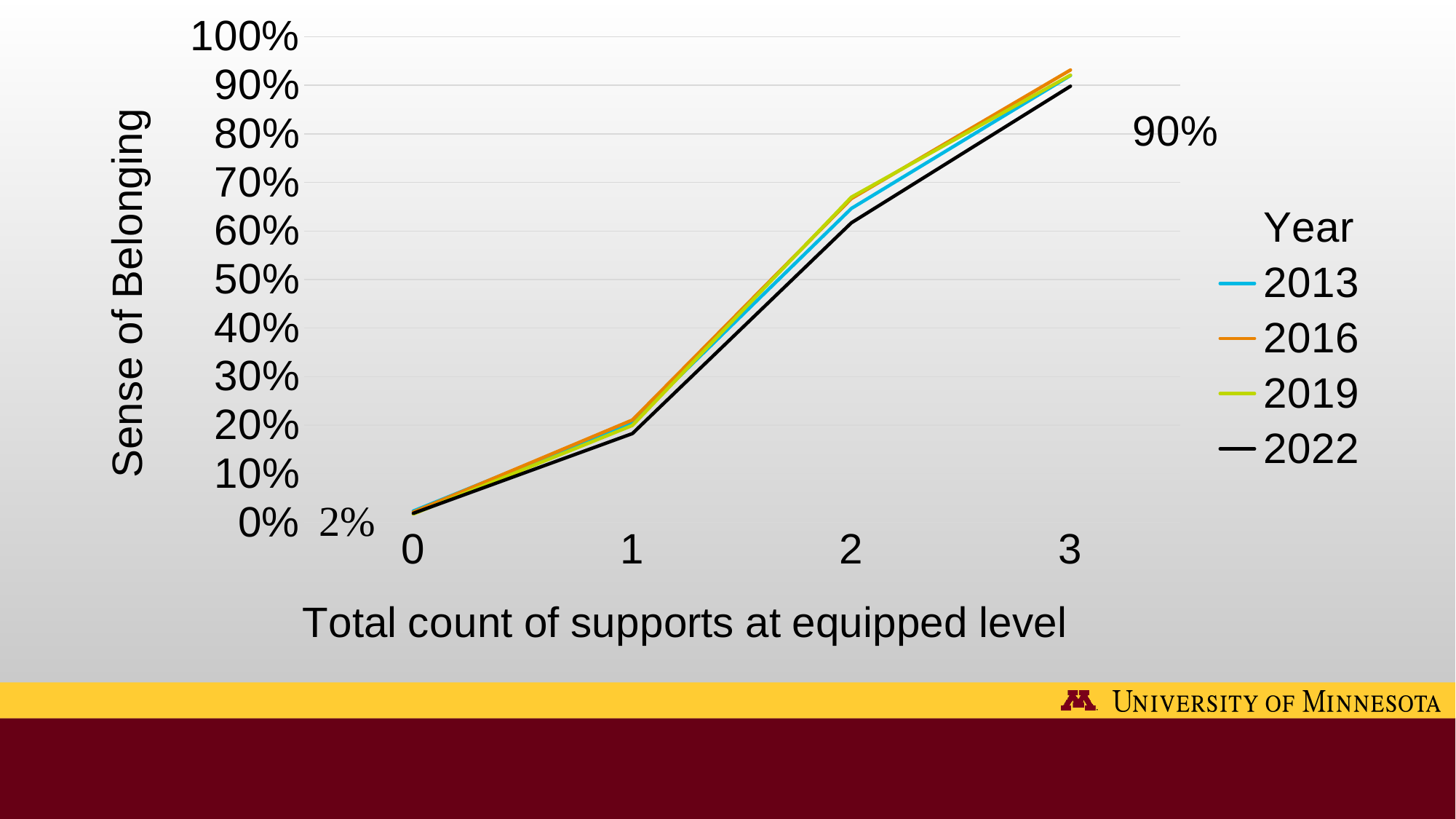
Is the value for the 2022 series at a support count of 2 greater or less than 50%? greater At a support count of 2, which is higher: the 2019 series or the 2022 series? 2019 What kind of chart is shown on the slide? line chart Is the value for the 2013 series at a support count of 3 greater or less than 80%? greater What is the title of the legend? Year Do the values for the 2022 series rise or fall as the total count of supports increases from 0 to 3? rise Is the value for the 2016 series at a support count of 0 greater or less than 10%? less At a support count of 3, which series has the lowest sense of belonging? 2022 What is the label of the y axis? Sense of Belonging How many series does the legend list? 4 How many points along the x axis (total count of supports) are plotted for each series? 4